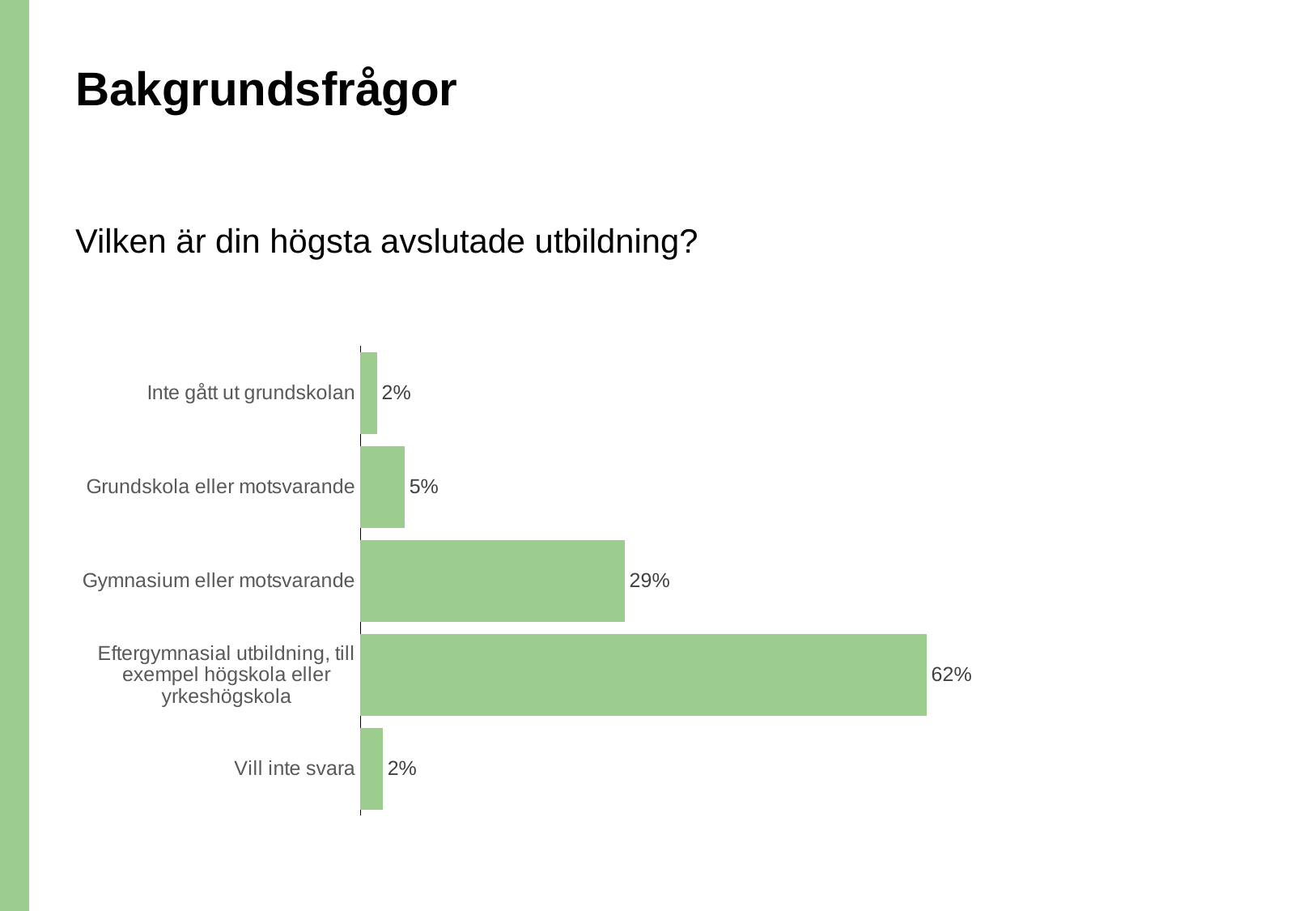
What kind of chart is shown on the slide? Bar chart What is the value for "Eftergymnasial utbildning, till exempel högskola eller yrkeshögskola"? 62% What is the value for "Vill inte svara"? 2% What is the difference between the values for "Grundskola eller motsvarande" and "Inte gått ut grundskolan"? 3% What question does the chart answer, as stated above it? Vilken är din högsta avslutade utbildning? What colour are the bars in the chart? Green Which category has the highest value? Eftergymnasial utbildning, till exempel högskola eller yrkeshögskola What is the value for "Grundskola eller motsvarande"? 5% How many categories are shown in the chart? 5 What is the difference between the values for "Eftergymnasial utbildning, till exempel högskola eller yrkeshögskola" and "Gymnasium eller motsvarande"? 33% What is the value for "Gymnasium eller motsvarande"? 29% Which is larger, the value for "Gymnasium eller motsvarande" or the value for "Grundskola eller motsvarande"? Gymnasium eller motsvarande